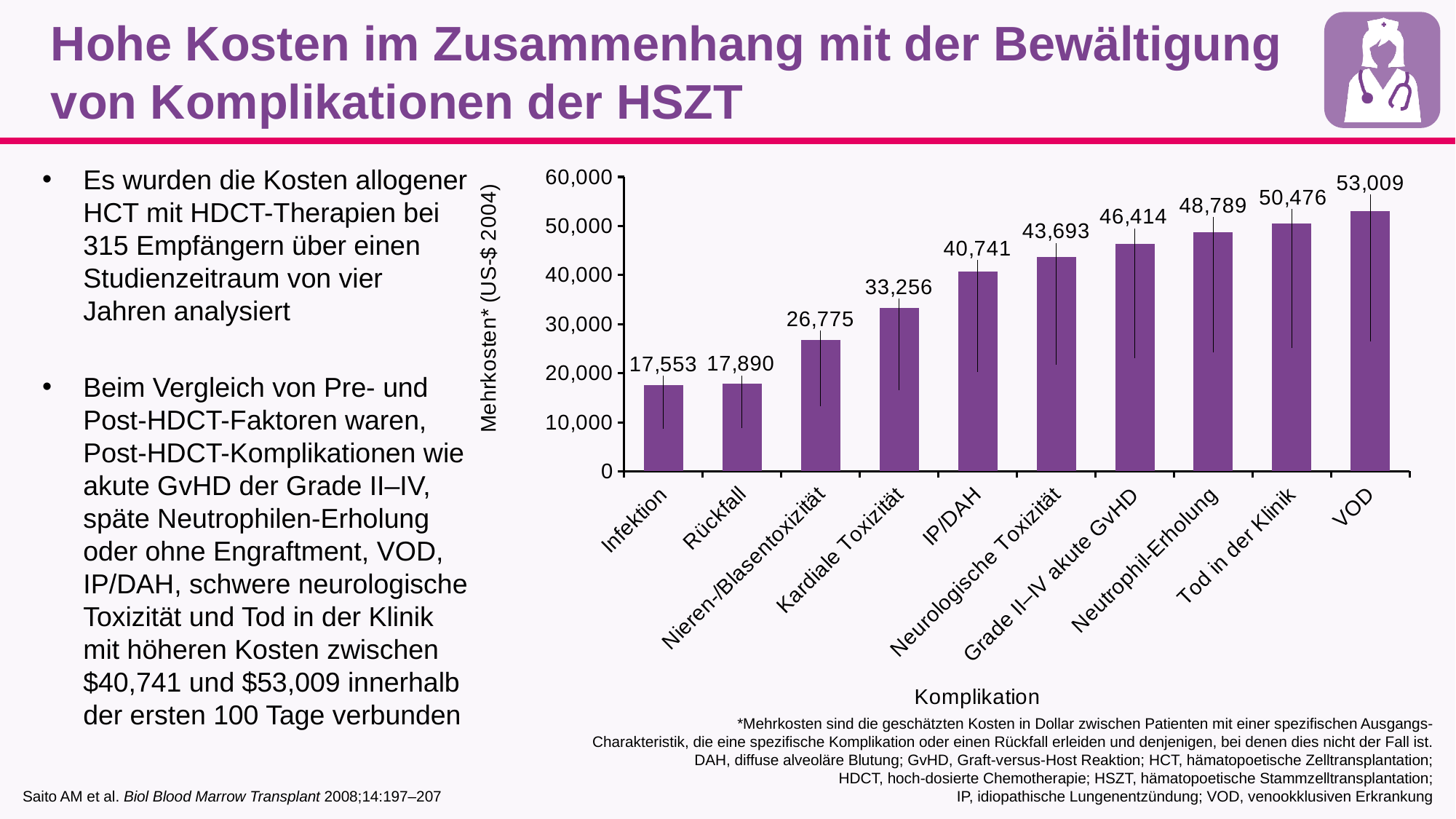
Which Komplikation has the lowest Mehrkosten? Infektion What is the difference in Mehrkosten between VOD and Infektion? 35,456 Which Komplikation has the highest Mehrkosten? VOD What is the Mehrkosten value for Grade II–IV akute GvHD? 46,414 How many Komplikation categories are shown in the chart? 10 What is the label of the y axis of the chart? Mehrkosten* (US-$ 2004) Which has higher Mehrkosten, IP/DAH or Nieren-/Blasentoxizität? IP/DAH What is the Mehrkosten value for Infektion? 17,553 Is the Mehrkosten value for Neurologische Toxizität greater or less than 40,000? greater What kind of chart is shown on the slide? Bar chart What is the difference in Mehrkosten between Tod in der Klinik and Neutrophil-Erholung? 1,687 What is the Mehrkosten value for Kardiale Toxizität? 33,256